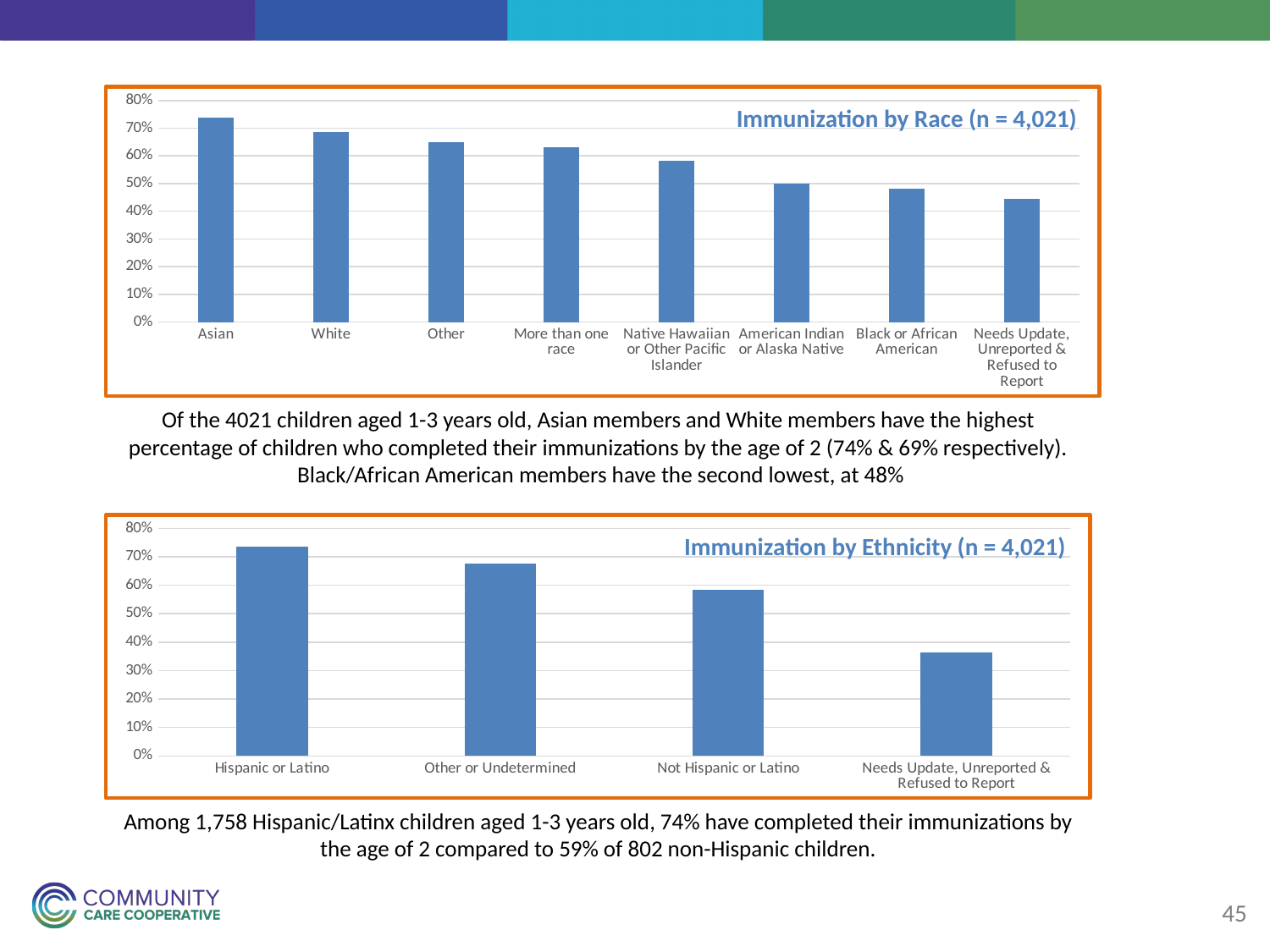
What kind of chart is the Immunization by Ethnicity chart? bar chart In the Immunization by Ethnicity chart, how many categories are plotted? 4 In the Immunization by Race chart, is the value for Other greater or less than 60%? greater In the Immunization by Race chart, do the values rise or fall moving from left to right along the x axis? fall In the Immunization by Race chart, which category has the highest bar? Asian In the Immunization by Ethnicity chart, which category has the highest bar? Hispanic or Latino In the Immunization by Race chart, is the value for Native Hawaiian or Other Pacific Islander greater or less than 60%? less In the Immunization by Race chart, how many race categories are plotted? 8 In the Immunization by Race chart, which category has the lowest bar? Needs Update, Unreported & Refused to Report In the Immunization by Ethnicity chart, which is larger, the value for Other or Undetermined or the value for Not Hispanic or Latino? Other or Undetermined In the Immunization by Ethnicity chart, is the value for Needs Update, Unreported & Refused to Report greater or less than 40%? less In the Immunization by Race chart, what is the difference between the Asian and White immunization percentages stated on the slide? 5%